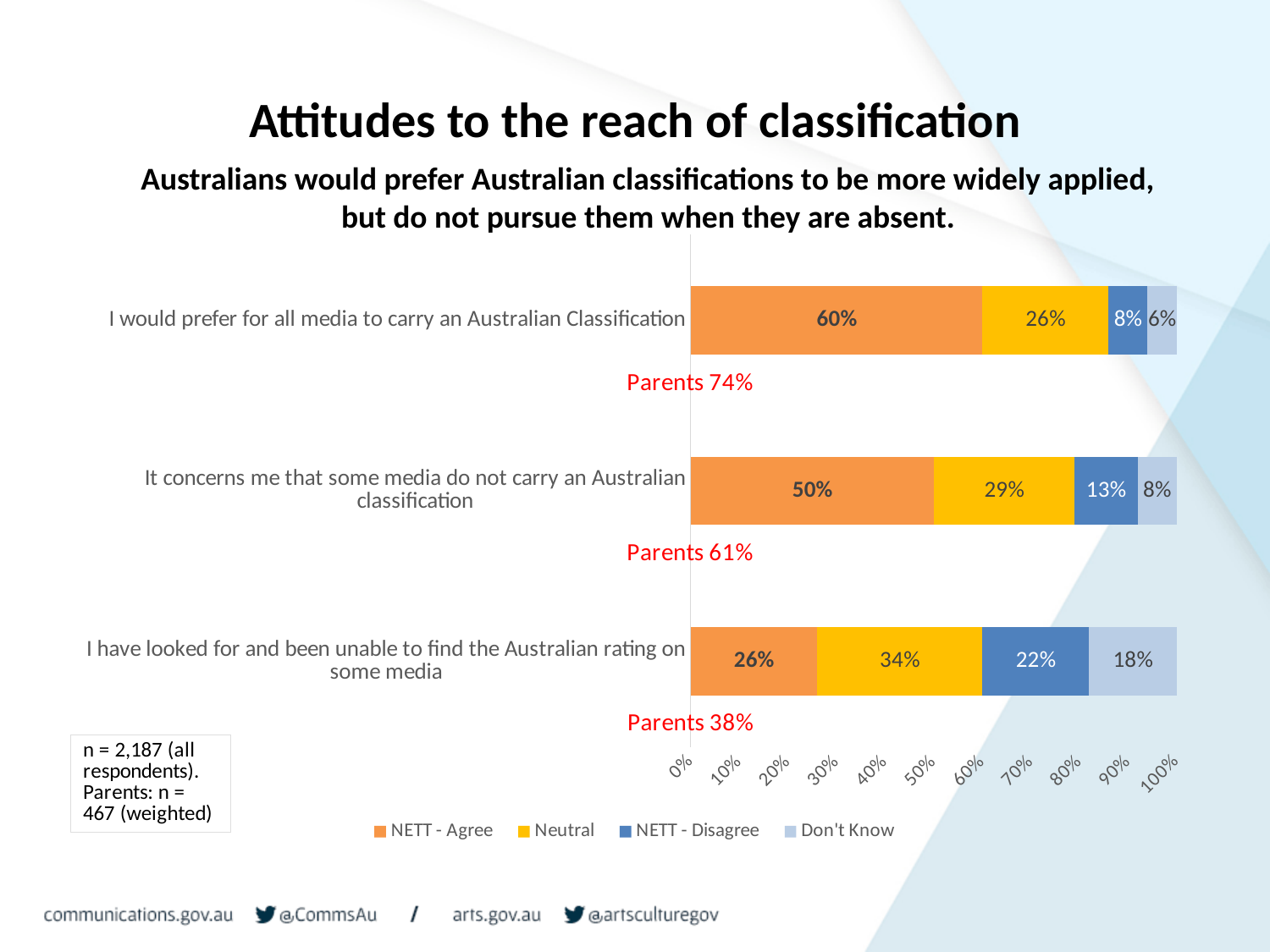
How many series does the legend list? 4 What is the Parents NETT - Agree figure annotated for "It concerns me that some media do not carry an Australian classification"? 61% Which is larger: the Neutral value for "I have looked for and been unable to find the Australian rating on some media" or the Neutral value for "I would prefer for all media to carry an Australian Classification"? I have looked for and been unable to find the Australian rating on some media What is the NETT - Disagree value for "It concerns me that some media do not carry an Australian classification"? 13% Which statement has the lowest NETT - Agree value? I have looked for and been unable to find the Australian rating on some media What type of chart is shown on the slide? Stacked bar chart What is the Neutral value for "It concerns me that some media do not carry an Australian classification"? 29% How many statements (categories) are plotted in the chart? 3 What is the Don't Know value for "I have looked for and been unable to find the Australian rating on some media"? 18% Which statement has the highest NETT - Agree value? I would prefer for all media to carry an Australian Classification What is the difference between the NETT - Agree values for "I would prefer for all media to carry an Australian Classification" and "It concerns me that some media do not carry an Australian classification"? 10% What is the NETT - Agree value for "I would prefer for all media to carry an Australian Classification"? 60%